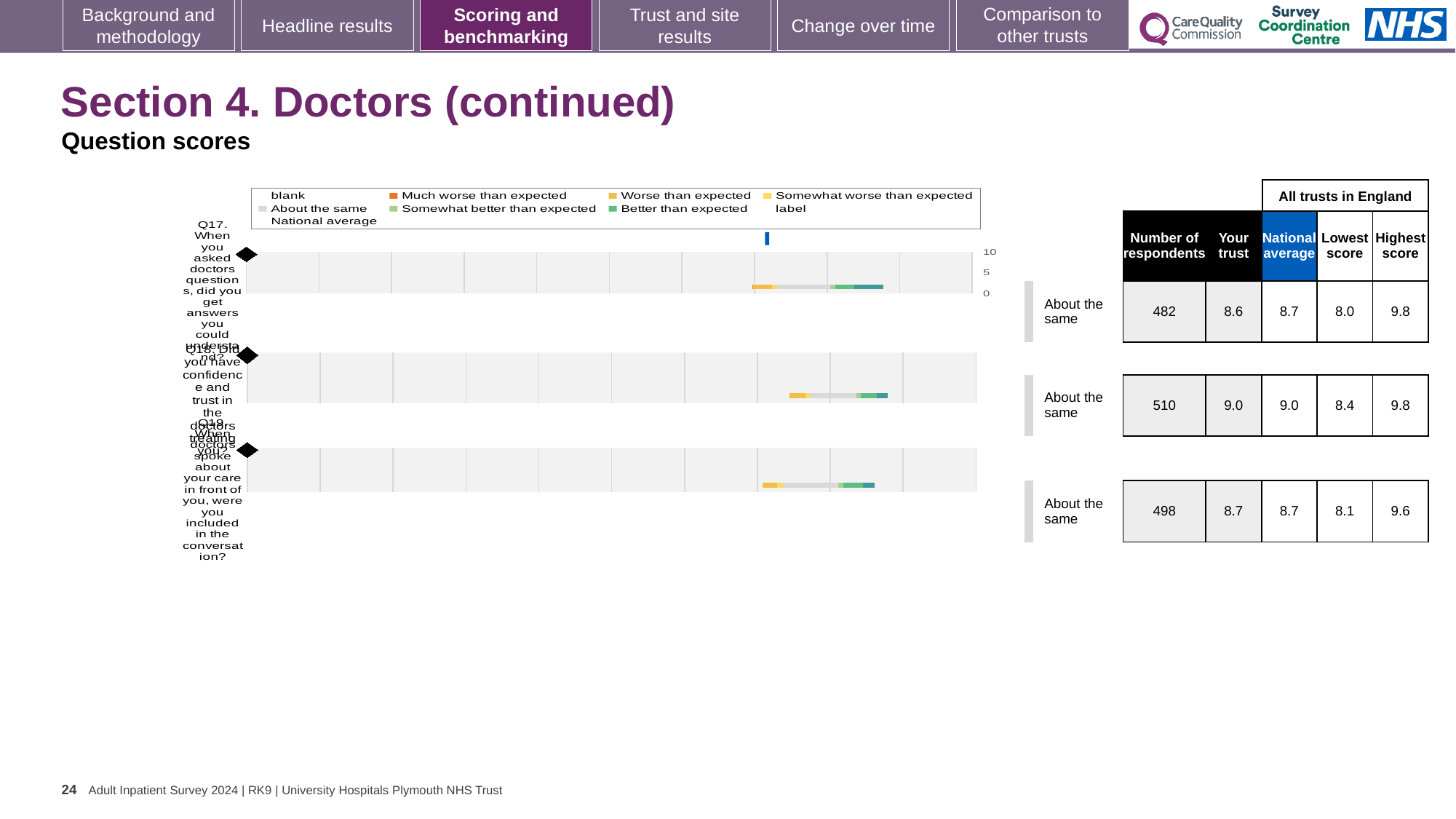
What colour does the legend use for 'Much worse than expected'? orange For Q17, what is the difference between the highest score and the lowest score in the table? 1.8 What kind of chart is shown on the slide? bar chart What is the highest tick value shown on the chart's score axis? 10 In the table beside the chart, what is the national average for Q18? 9.0 How many questions (bars) are plotted in the chart? 3 In the table beside the chart, what is the 'Your trust' score for Q17? 8.6 Which question has the highest 'Your trust' score in the table beside the chart? Q18 What benchmark category is shown for Q19? About the same For Q17, which is larger: the 'Your trust' score or the national average? National average In the table beside the chart, how many respondents are listed for Q19? 498 How many entries does the chart legend list? 9